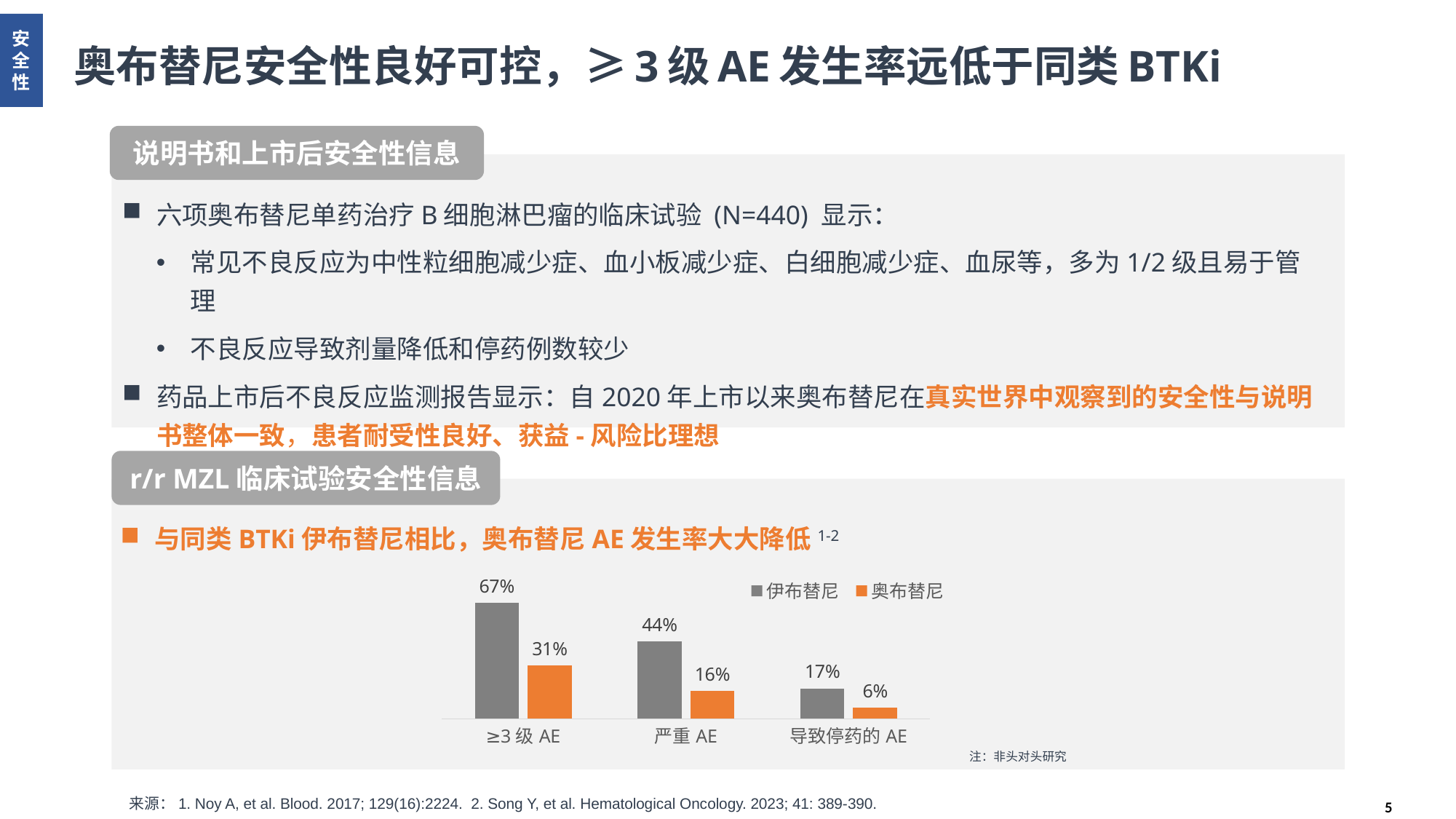
How many categories are shown on the x axis of the chart? 3 Which category has the lowest value for 奥布替尼? 导致停药的 AE What is the value for 奥布替尼 in the ≥3 级 AE category? 31% Which category has the highest value for 伊布替尼? ≥3 级 AE What kind of chart is shown on the slide? Bar chart What is the difference between 伊布替尼 and 奥布替尼 in the 严重 AE category? 28% What is the difference between 伊布替尼 and 奥布替尼 in the ≥3 级 AE category? 36% Which is larger in the 导致停药的 AE category, 伊布替尼 or 奥布替尼? 伊布替尼 What is the value for 伊布替尼 in the 严重 AE category? 44% What is the value for 奥布替尼 in the 导致停药的 AE category? 6% How many series does the chart legend list? 2 What is the value for 伊布替尼 in the ≥3 级 AE category? 67%